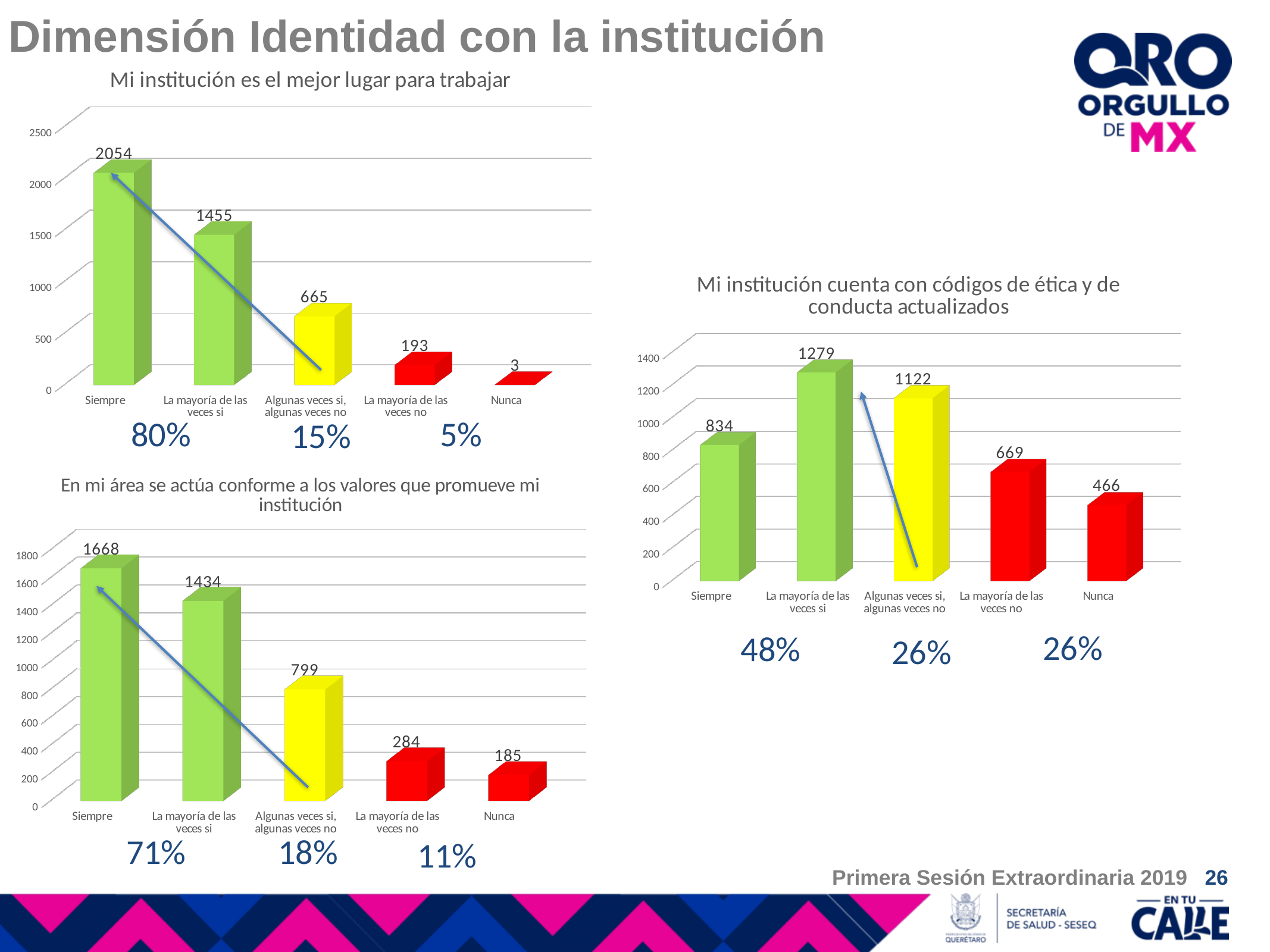
In the chart titled 'En mi área se actúa conforme a los valores que promueve mi institución', what is the difference between 'La mayoría de las veces no' and 'Nunca'? 99 In the chart titled 'En mi área se actúa conforme a los valores que promueve mi institución', do the values rise or fall from left to right along the x axis? fall In the chart titled 'Mi institución cuenta con códigos de ética y de conducta actualizados', which category has the highest value? La mayoría de las veces si In the chart titled 'Mi institución es el mejor lugar para trabajar', which category has the lowest value? Nunca In the chart titled 'Mi institución cuenta con códigos de ética y de conducta actualizados', which is larger: 'Siempre' or 'La mayoría de las veces no'? Siempre In the chart titled 'Mi institución es el mejor lugar para trabajar', how many categories are shown on the x axis? 5 In the chart titled 'En mi área se actúa conforme a los valores que promueve mi institución', what is the value for 'Algunas veces si, algunas veces no'? 799 In the chart titled 'Mi institución es el mejor lugar para trabajar', what is the value for 'Siempre'? 2054 In the chart titled 'Mi institución cuenta con códigos de ética y de conducta actualizados', what is the value for 'Nunca'? 466 In the chart titled 'Mi institución es el mejor lugar para trabajar', what is the difference between 'Siempre' and 'La mayoría de las veces si'? 599 In the chart titled 'Mi institución cuenta con códigos de ética y de conducta actualizados', what colour are the bars for 'La mayoría de las veces no' and 'Nunca'? red What kind of chart is the one titled 'Mi institución es el mejor lugar para trabajar'? bar chart